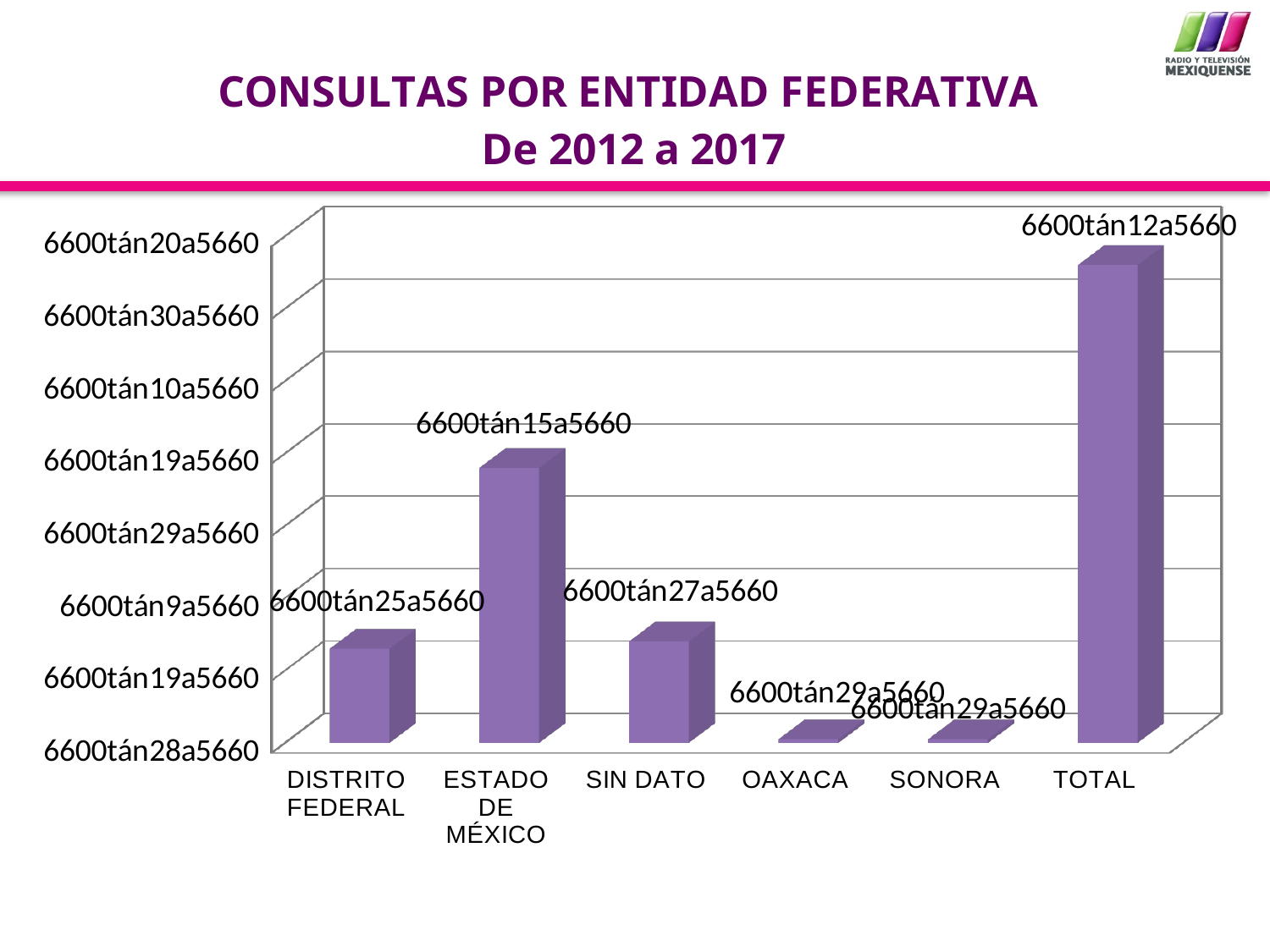
Which bar is taller, SIN DATO or OAXACA? SIN DATO Which bar is taller, TOTAL or ESTADO DE MÉXICO? TOTAL What is the title of the chart on the slide? CONSULTAS POR ENTIDAD FEDERATIVA De 2012 a 2017 Which category is listed first on the x axis of the chart? DISTRITO FEDERAL Which bar is taller, DISTRITO FEDERAL or SONORA? DISTRITO FEDERAL How many categories are shown on the x axis of the chart? 6 Which category has the tallest bar in the chart? TOTAL What colour are the bars in the chart? Purple What kind of chart is shown on the slide? Bar chart Among the individual entities (excluding TOTAL), which category has the tallest bar? ESTADO DE MÉXICO